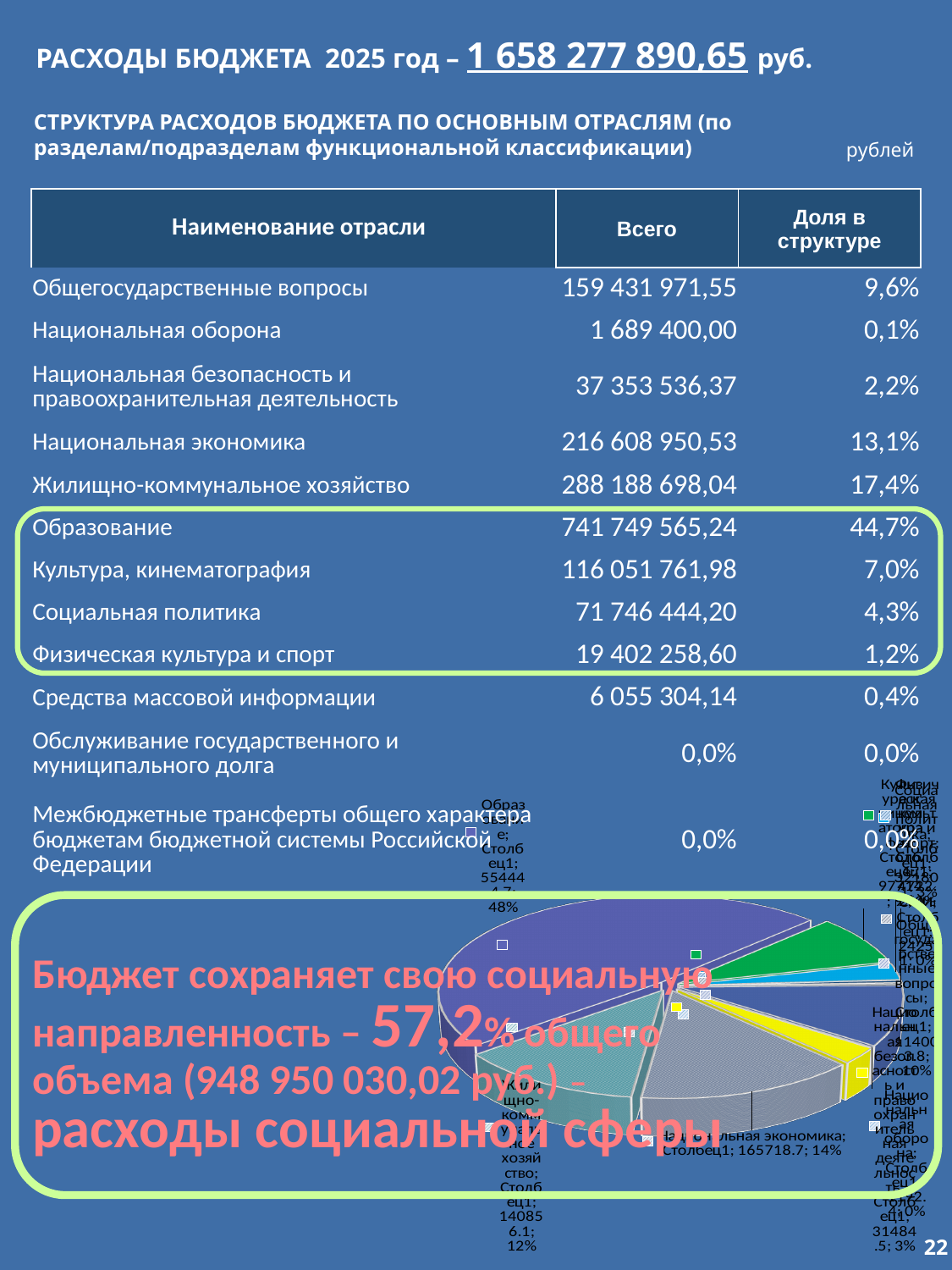
In the pie chart, what share is shown for Национальная экономика? 14% Which slice of the pie chart is the largest? Образование In the pie chart, by how many percentage points does the share of Образование exceed the share of Национальная экономика? 34% In the pie chart, which is larger: the slice for Национальная экономика or the slice for Жилищно-коммунальное хозяйство? Национальная экономика Is the pie chart drawn in 3D or flat 2D? 3D In the pie chart, what share is shown for Жилищно-коммунальное хозяйство? 12% What kind of chart is shown at the bottom of the slide? pie chart In the pie chart, which is larger: the slice for Образование or the slice for Национальная экономика? Образование In the pie chart, what value is printed for Национальная экономика? 165718.7 In the pie chart, what share is shown for Образование? 48%